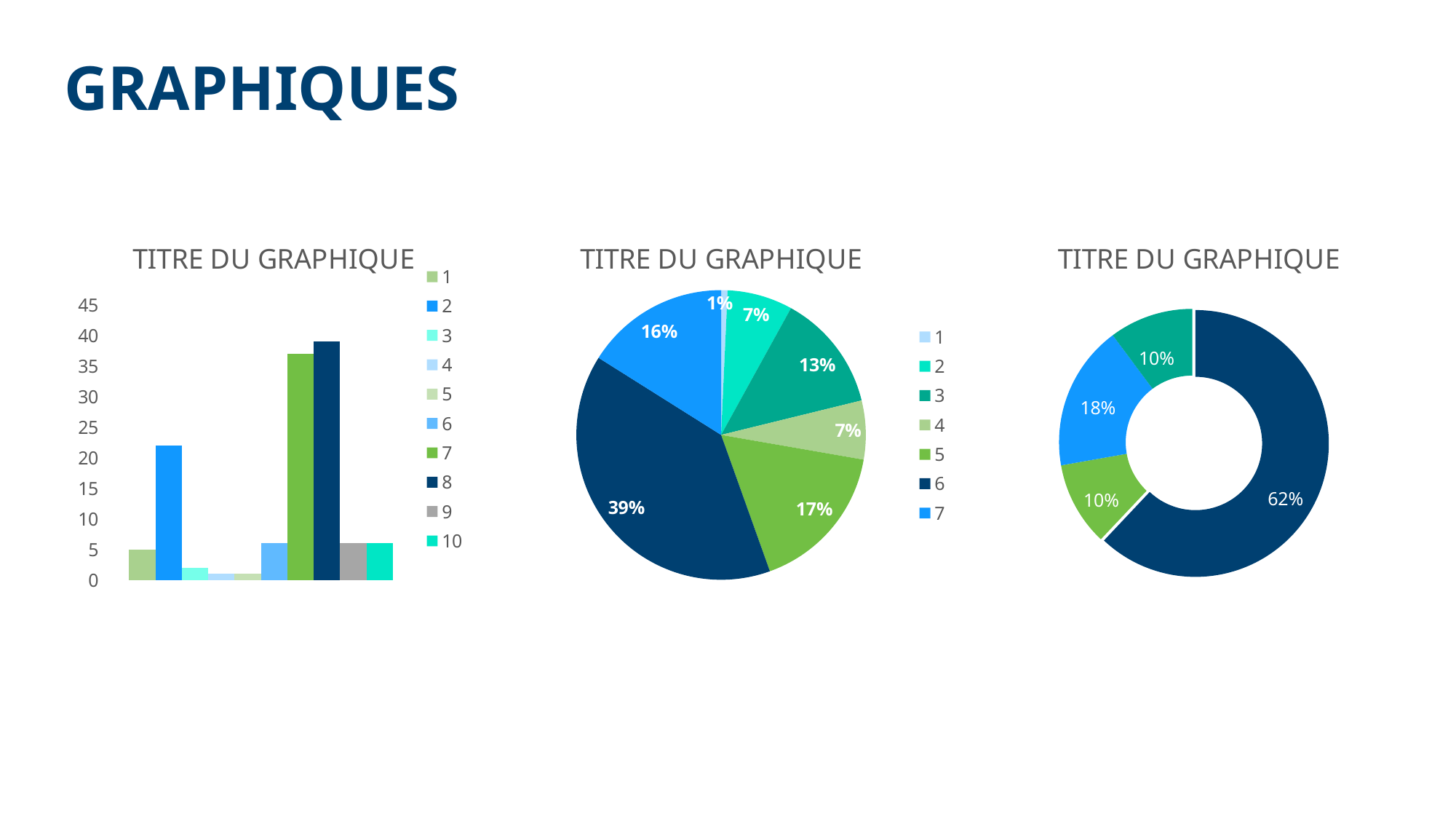
In the right doughnut chart, what is the share of the largest slice? 62% In the left bar chart, is the value for series 2 greater or less than 20? greater How many series does the legend of the left bar chart list? 10 In the left bar chart, is the value for series 1 greater or less than 10? less In the middle pie chart, what share does slice 6 have? 39% What kind of chart is the middle chart on the slide? pie chart In the left bar chart, which is larger, the value for series 2 or the value for series 7? series 7 What kind of chart is the left chart on the slide? bar chart In the left bar chart, is the value for series 7 greater or less than 35? greater In the middle pie chart, which slice is the smallest? 1 In the middle pie chart, what is the difference between the shares of slice 5 and slice 7? 1% In the middle pie chart, what share does slice 3 have? 13%